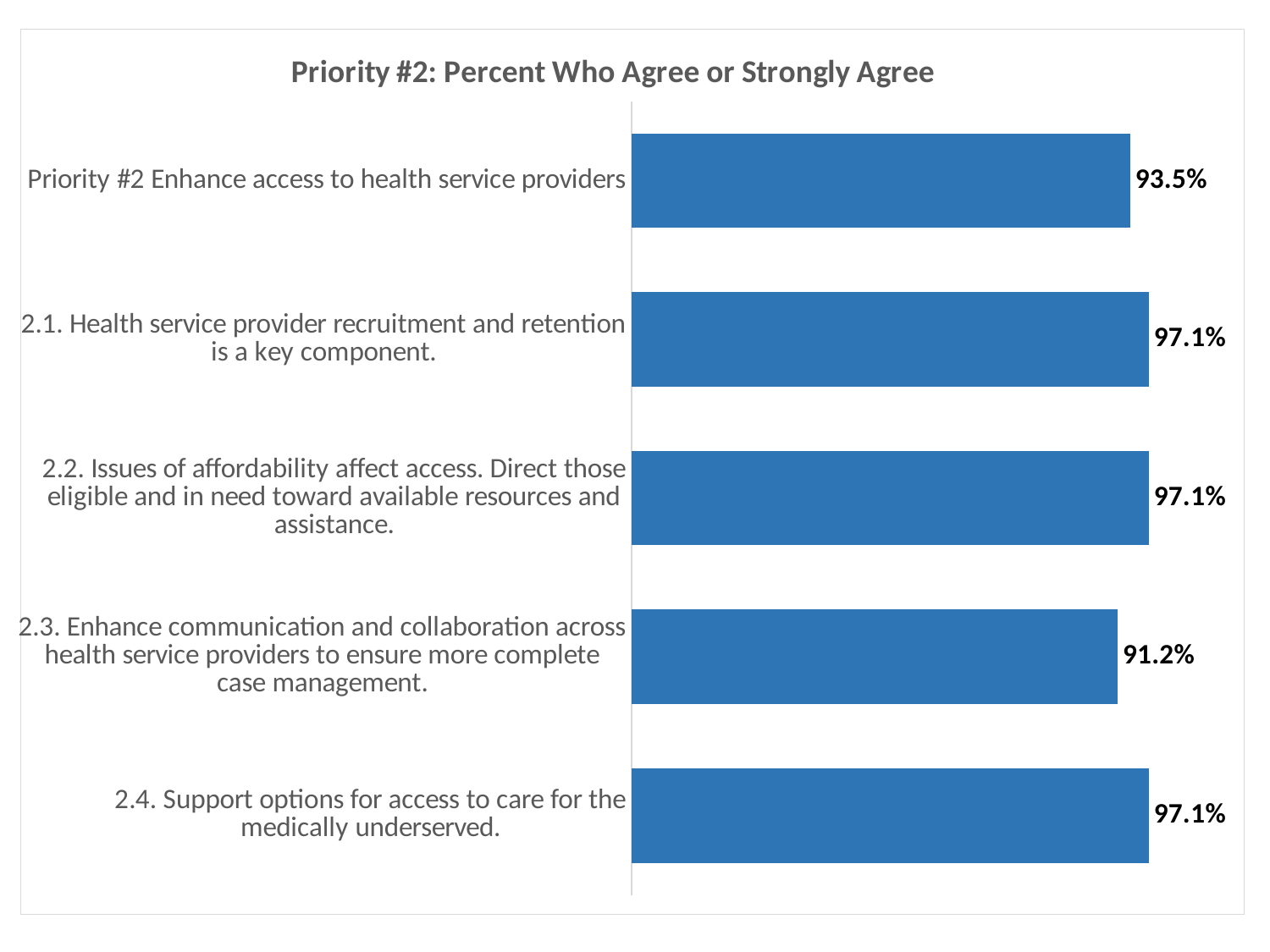
How many categories share the highest value of 97.1%? 3 What is the value for item 2.4 (Support options for access to care for the medically underserved)? 97.1% Which category has the lowest value? 2.3. Enhance communication and collaboration across health service providers to ensure more complete case management. What kind of chart is this? Bar chart What is the difference between the value for item 2.1 and the value for item 2.3? 5.9% What is the value for item 2.3 (Enhance communication and collaboration across health service providers)? 91.2% Which is larger: the value for item 2.4 or the value for item 2.3? 2.4. Support options for access to care for the medically underserved. What percent agree or strongly agree with item 2.1 (Health service provider recruitment and retention is a key component)? 97.1% How many categories are shown in the chart? 5 What is the difference between the value for item 2.2 and the value for "Priority #2 Enhance access to health service providers"? 3.6% What is the title of the chart? Priority #2: Percent Who Agree or Strongly Agree What is the value for "Priority #2 Enhance access to health service providers"? 93.5%